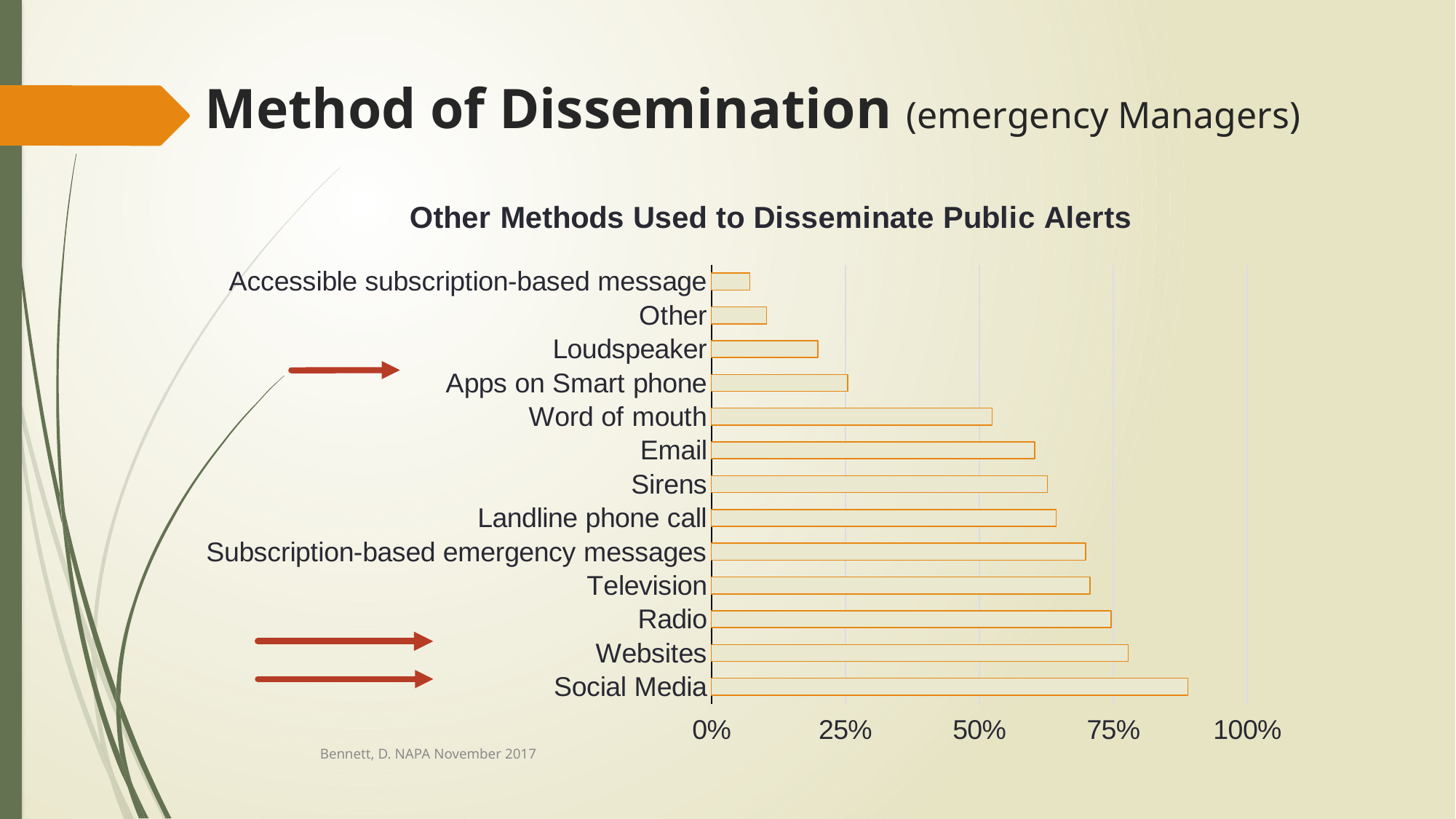
What is the title of the chart? Other Methods Used to Disseminate Public Alerts Is the value for Social Media greater or less than 75%? greater How many methods (categories) are plotted in the chart? 13 Is the value for Television greater or less than 75%? less Which method has the highest value in the chart? Social Media Which method has the lowest value in the chart? Accessible subscription-based message Which has a larger value, Social Media or Websites? Social Media Is the value for Email greater or less than 50%? greater What kind of chart is shown on the slide? bar chart Which has a larger value, Other or Loudspeaker? Loudspeaker Which has a larger value, Word of mouth or Email? Email